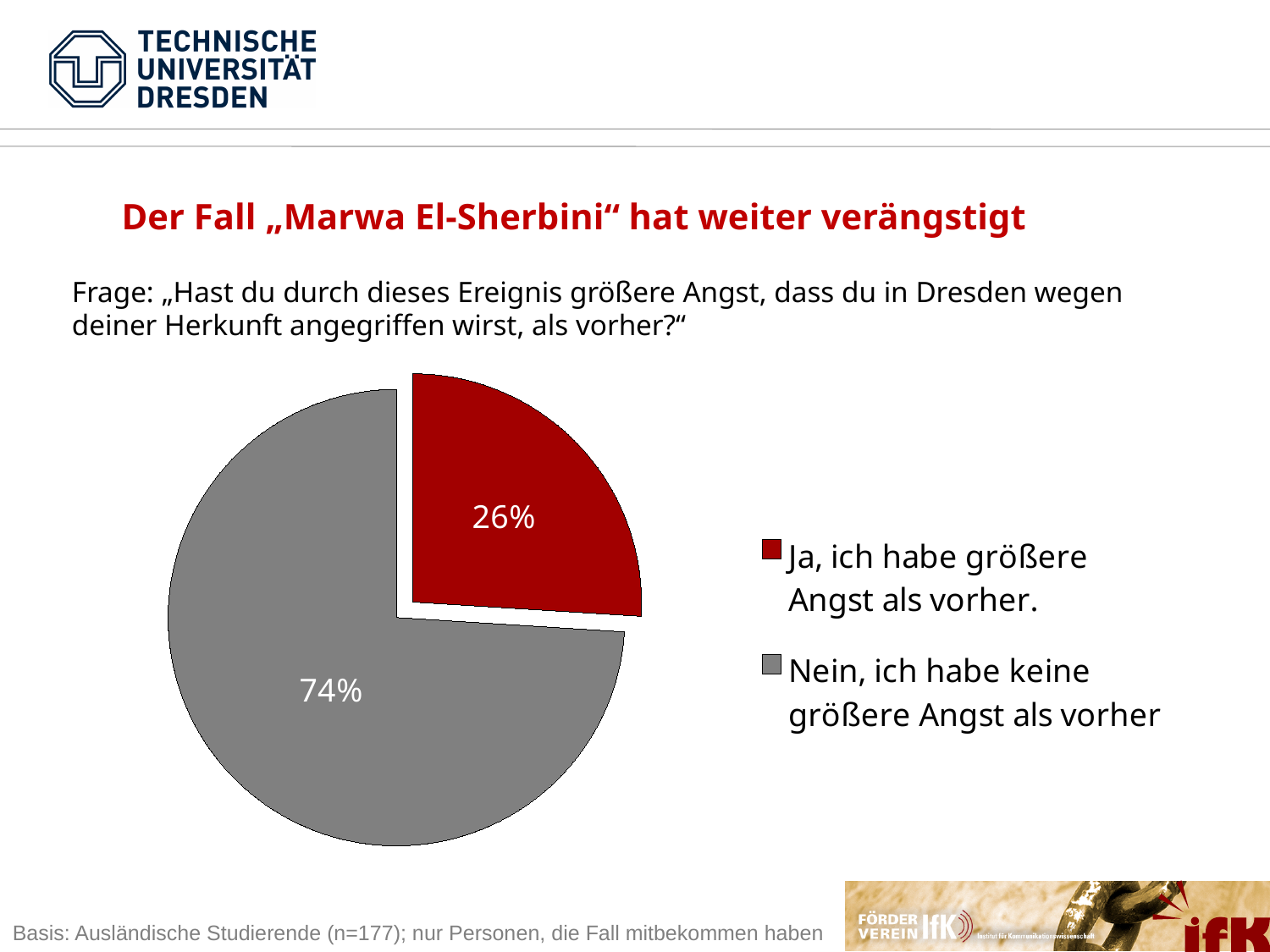
Which slice of the pie is the largest? Nein, ich habe keine größere Angst als vorher How many entries does the legend list? 2 What share of the pie is labelled "Nein, ich habe keine größere Angst als vorher"? 74% What is the total of the two slices shown in the pie chart? 100% What is the difference in percentage points between the "Nein" slice and the "Ja" slice? 48 Which slice of the pie is the smallest? Ja, ich habe größere Angst als vorher. What share of the pie is labelled "Ja, ich habe größere Angst als vorher."? 26% What colour is the slice for "Nein, ich habe keine größere Angst als vorher"? grey How many slices does the pie chart have? 2 What colour is the slice for "Ja, ich habe größere Angst als vorher."? red Which is larger: the "Ja, ich habe größere Angst als vorher." slice or the "Nein, ich habe keine größere Angst als vorher" slice? Nein, ich habe keine größere Angst als vorher What kind of chart is shown on the slide? pie chart